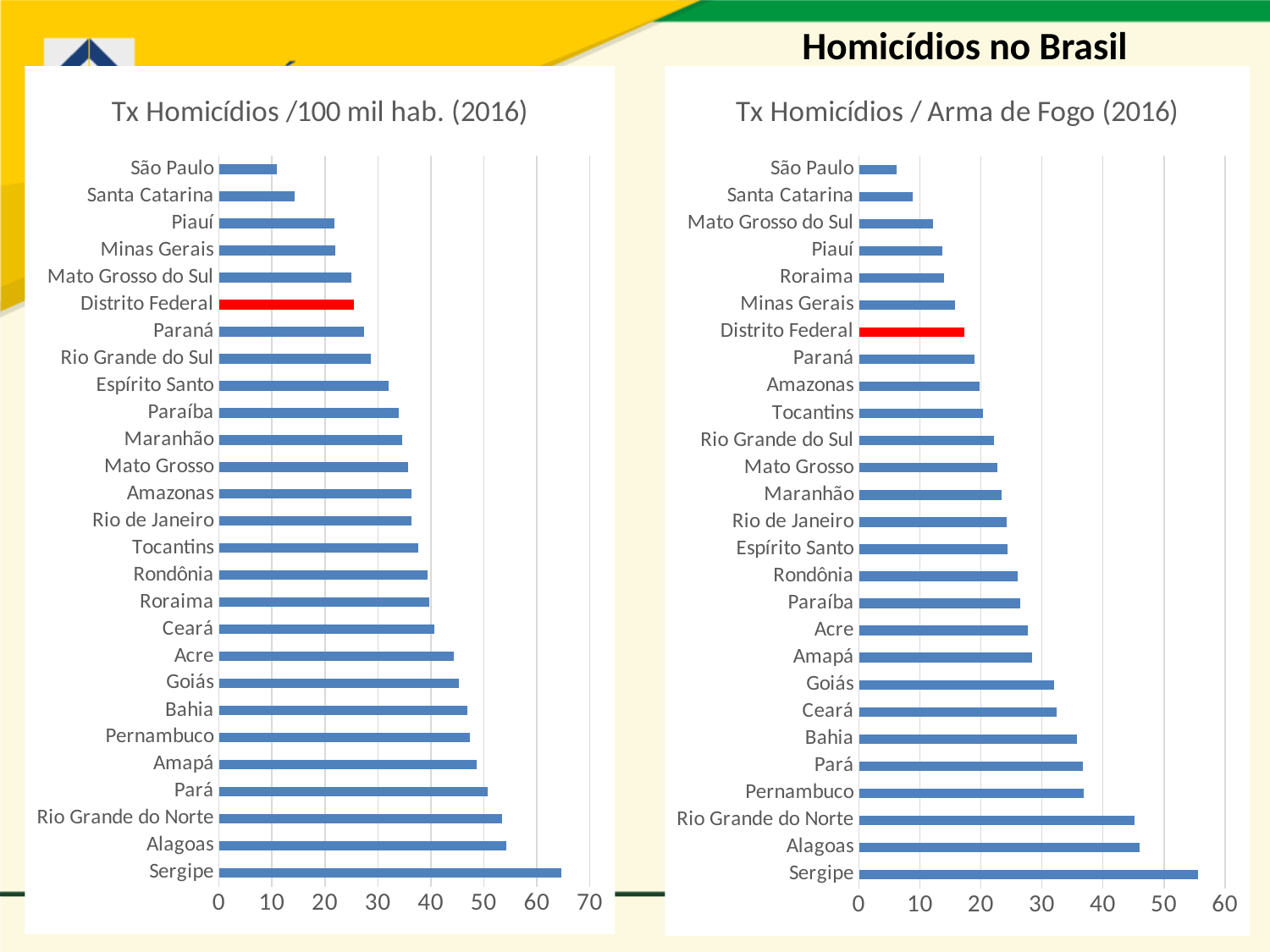
In the right chart, which has the larger value, Rio Grande do Norte or Goiás? Rio Grande do Norte How many states are shown in the chart titled "Tx Homicídios / Arma de Fogo (2016)"? 27 In the chart titled "Tx Homicídios /100 mil hab. (2016)", which state has the lowest value? São Paulo In the left chart, is the value for Sergipe greater or less than 60? greater In the left chart, which has the larger value, Sergipe or Alagoas? Sergipe In the chart titled "Tx Homicídios / Arma de Fogo (2016)", which state has the lowest value? São Paulo In the chart titled "Tx Homicídios /100 mil hab. (2016)", which state has the highest value? Sergipe What type of chart is the left chart on the slide? Bar chart In the right chart, is the value for Sergipe greater or less than 50? greater In the left chart, is the value for Distrito Federal greater or less than 30? less In the chart titled "Tx Homicídios / Arma de Fogo (2016)", which state has the highest value? Sergipe